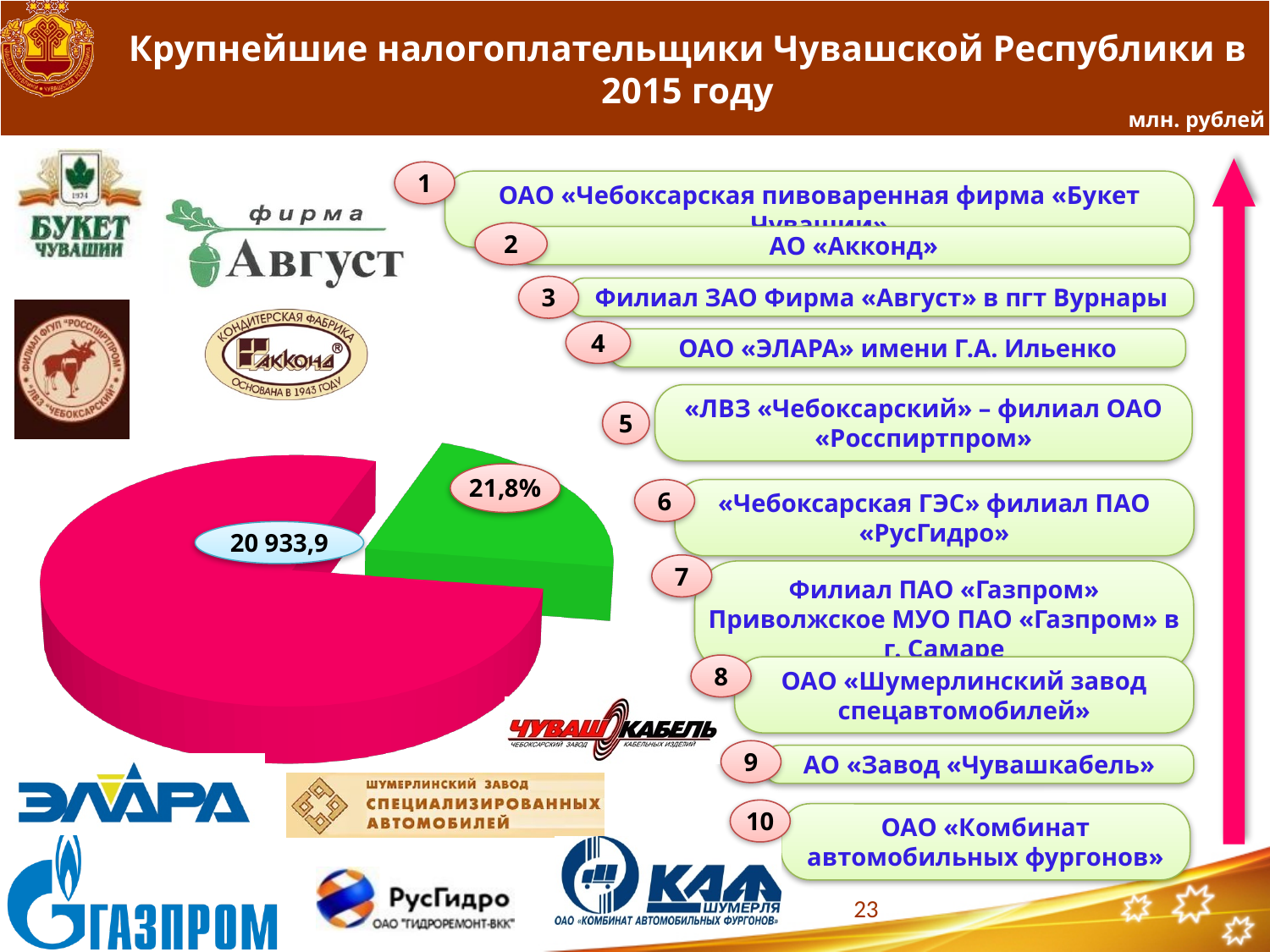
What is the title of the slide containing the pie chart? Крупнейшие налогоплательщики Чувашской Республики в 2015 году Which slice of the pie chart is the largest? the pink slice What share of the pie does the pink slice represent, given the green slice is 21,8%? 78,2% What number is printed on the pink slice of the pie chart? 20 933,9 In what units are the values on the slide expressed, according to the label in the top right? млн. рублей Which slice of the pie chart is larger, the pink one or the green one? the pink one What share of the pie does the green slice represent? 21,8% Which slice of the pie chart is the smallest? the green slice How many slices does the pie chart have? 2 Is the share of the green slice greater or less than 50%? less What kind of chart is shown on the slide? pie chart